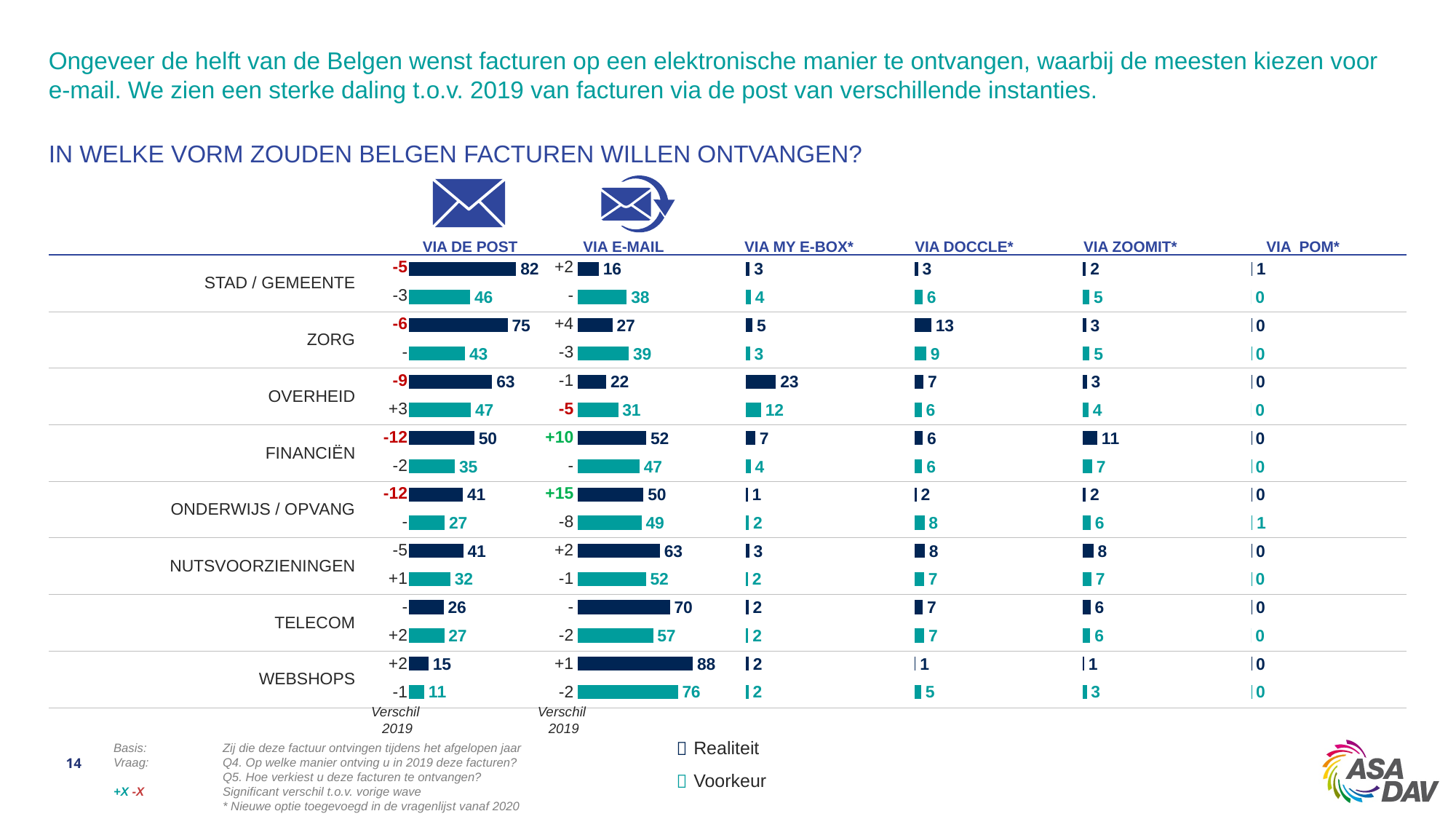
How many categories (rows) are shown in the chart? 8 Which category has the highest Realiteit value via e-mail? WEBSHOPS What is the Realiteit value for STAD / GEMEENTE via de post? 82 What are the two series named in the legend? Realiteit and Voorkeur What is the difference between the Realiteit and Voorkeur values for STAD / GEMEENTE via de post? 36 For TELECOM, is the Realiteit value via e-mail larger or the Realiteit value via de post? via e-mail What is the Realiteit value for OVERHEID via My e-box? 23 Which category has the lowest Realiteit value via de post? WEBSHOPS What is the Voorkeur value for WEBSHOPS via e-mail? 76 What is the Voorkeur value for ZORG via Doccle? 9 What kind of chart is used to show the values? bar chart How many series does the legend list? 2